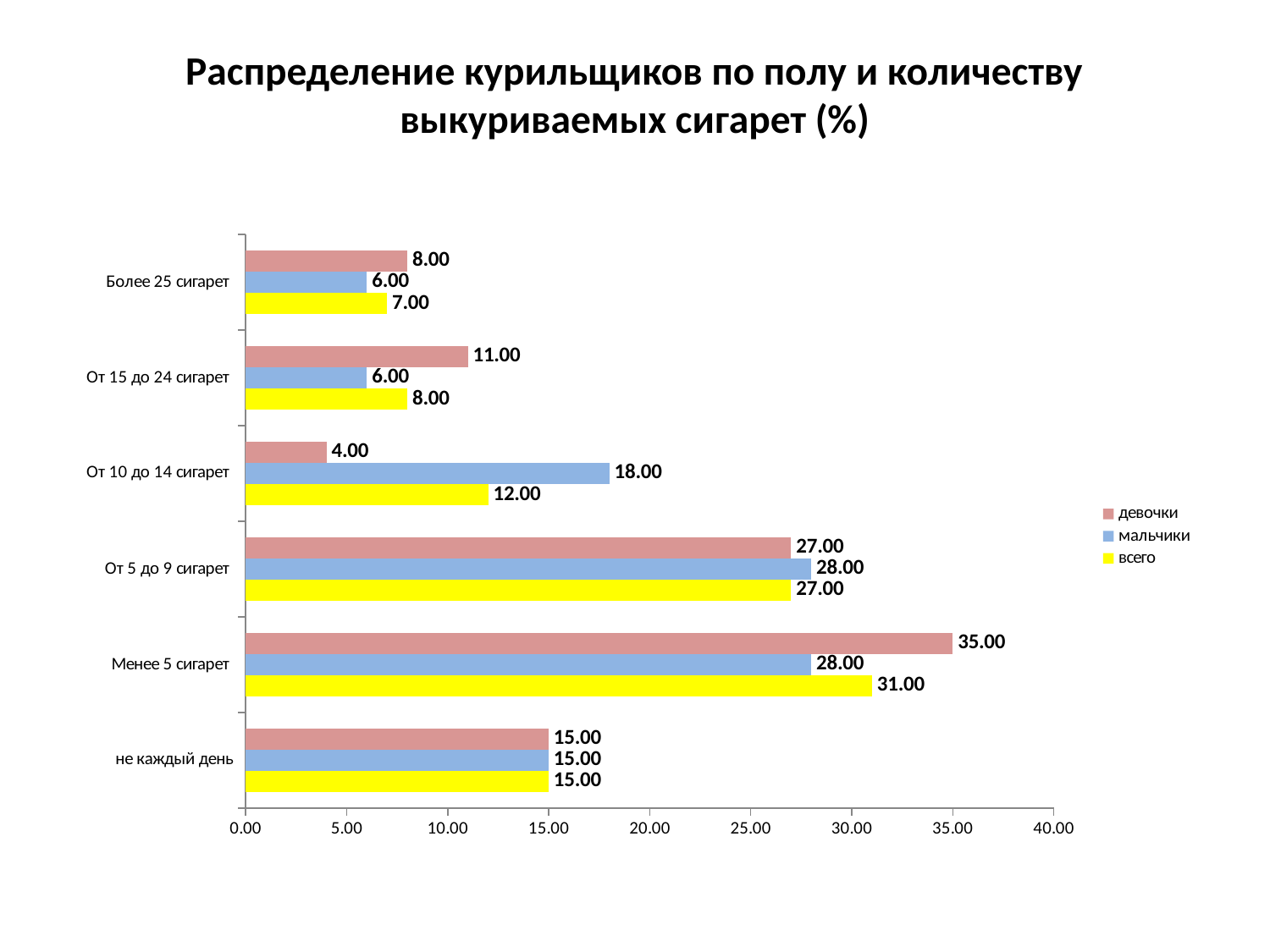
Which colour represents the series всего in the legend? yellow Which category has the highest value for девочки? Менее 5 сигарет What kind of chart is shown on the slide? bar chart Which is larger in the category Более 25 сигарет: девочки or мальчики? девочки How many series does the legend list? 3 What is the value for девочки in the category Менее 5 сигарет? 35.00 Which category has the lowest value for девочки? От 10 до 14 сигарет How many categories are shown on the chart? 6 What is the value for всего in the category От 15 до 24 сигарет? 8.00 What is the value for мальчики in the category От 10 до 14 сигарет? 18.00 What is the difference between девочки and мальчики in the category От 10 до 14 сигарет? 14.00 Is the value for всего in the category Менее 5 сигарет greater or less than 30.00? greater